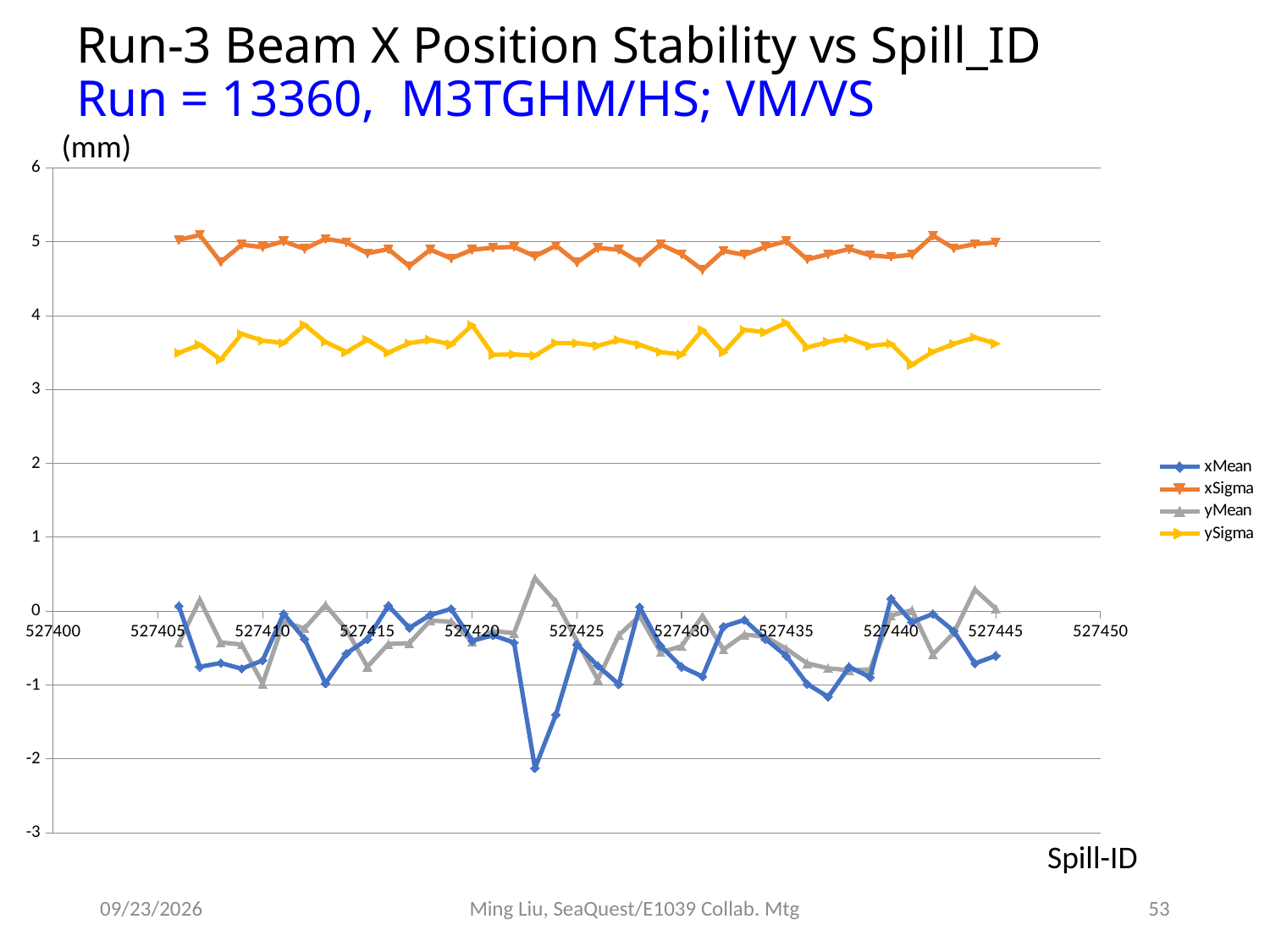
Which series has the highest values across the spills? xSigma How many series does the legend list? 4 Which series reaches the lowest value on the chart? xMean Are the xSigma values greater or less than 4? greater What are the series names listed in the legend? xMean, xSigma, yMean, ySigma At the spill where xMean dips to its lowest value, which is larger, xMean or yMean? yMean What unit is shown for the vertical axis? mm At Spill-ID 527420, which is larger, xSigma or ySigma? xSigma Is the lowest xMean value greater or less than -1? less What kind of chart is shown on the slide? line chart Are the ySigma values greater or less than 3? greater